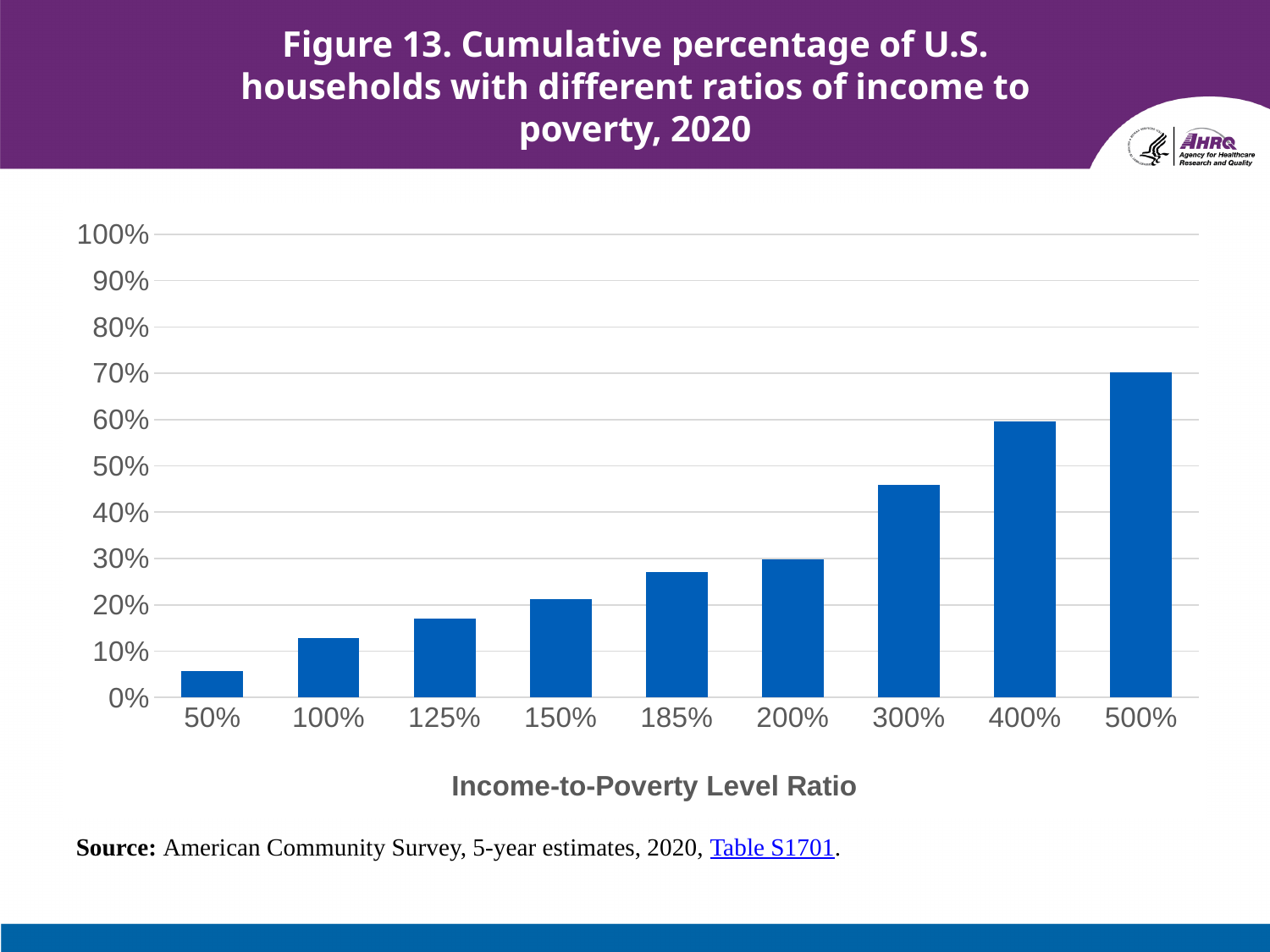
What is the label of the x axis on the chart? Income-to-Poverty Level Ratio Is the value for the 100% income-to-poverty ratio greater or less than 10%? greater How many income-to-poverty level ratio categories are plotted on the chart? 9 Is the value for the 50% income-to-poverty ratio greater or less than 10%? less Which income-to-poverty level ratio has the highest cumulative percentage of households? 500% Which income-to-poverty level ratio has the lowest cumulative percentage of households? 50% Which has a larger cumulative percentage of households: the 300% ratio or the 185% ratio? 300% Do the values rise or fall as the income-to-poverty level ratio increases along the x axis? rise What kind of chart is shown on the slide? bar chart Is the value for the 400% income-to-poverty ratio greater or less than 50%? greater